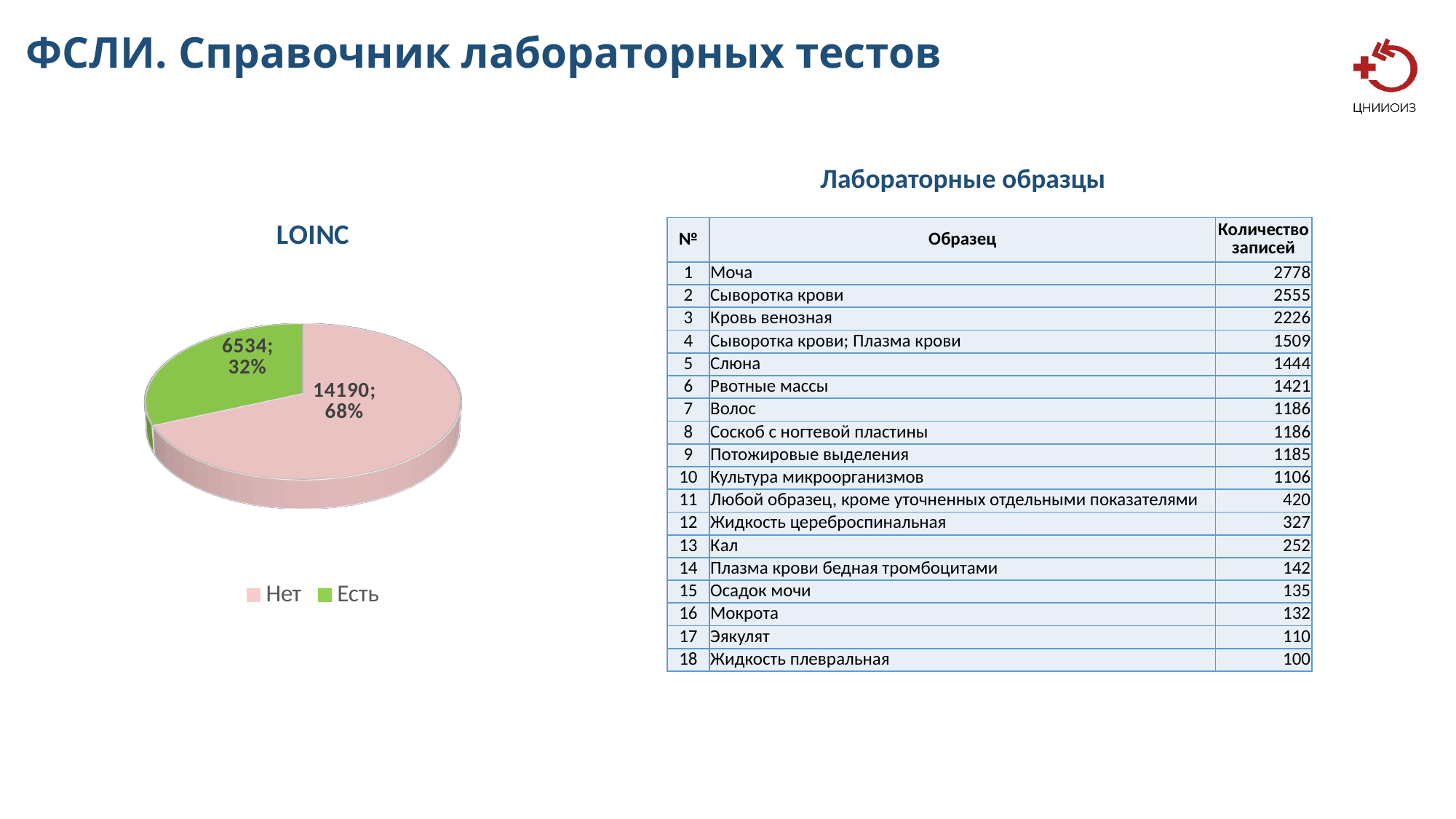
What kind of chart is the LOINC chart? pie chart In the LOINC pie chart, what share of the pie does "Нет" take? 68% In the LOINC pie chart, which is larger: "Нет" or "Есть"? Нет In the LOINC pie chart, which slice is the largest? Нет What is the title of the pie chart on the slide? LOINC How many slices does the LOINC pie chart have? 2 In the LOINC pie chart, what colour is the "Есть" slice? green In the LOINC pie chart, what is the value for "Нет"? 14190 In the LOINC pie chart, what share of the pie does "Есть" take? 32% In the LOINC pie chart, what is the difference between the values for "Нет" and "Есть"? 7656 In the LOINC pie chart, what is the value for "Есть"? 6534 In the LOINC pie chart, which slice is the smallest? Есть